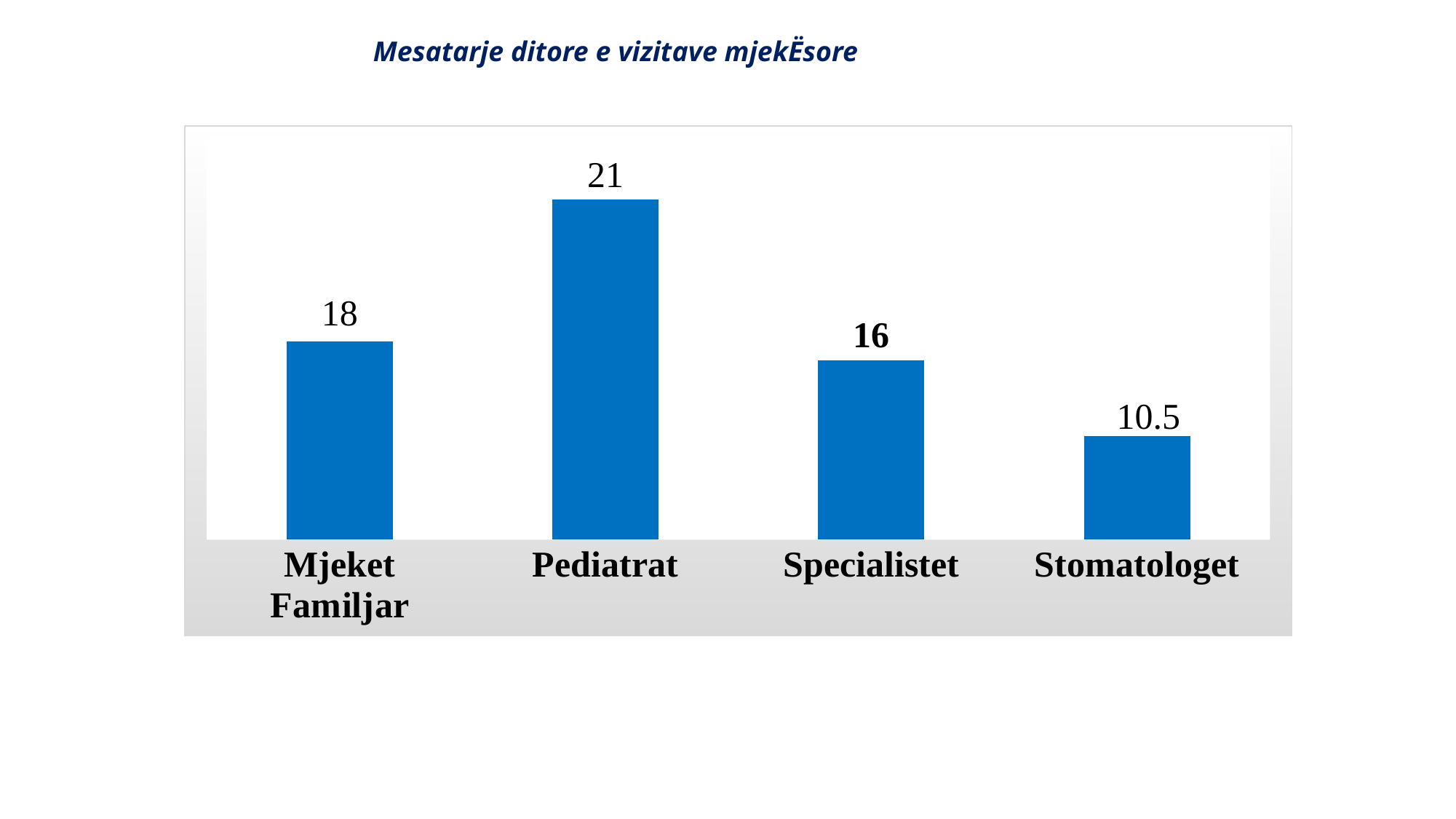
What is the title of the chart? Mesatarje ditore e vizitave mjekËsore How many categories are shown in the chart? 4 What is the value for Specialistet? 16 Which is larger, the value for Mjeket Familjar or the value for Specialistet? Mjeket Familjar What is the value for Mjeket Familjar? 18 Which category has the highest value? Pediatrat What kind of chart is shown on the slide? Bar chart What is the difference between the values for Specialistet and Stomatologet? 5.5 What is the value for Stomatologet? 10.5 What is the difference between the values for Pediatrat and Mjeket Familjar? 3 What is the value for Pediatrat? 21 Which category has the lowest value? Stomatologet